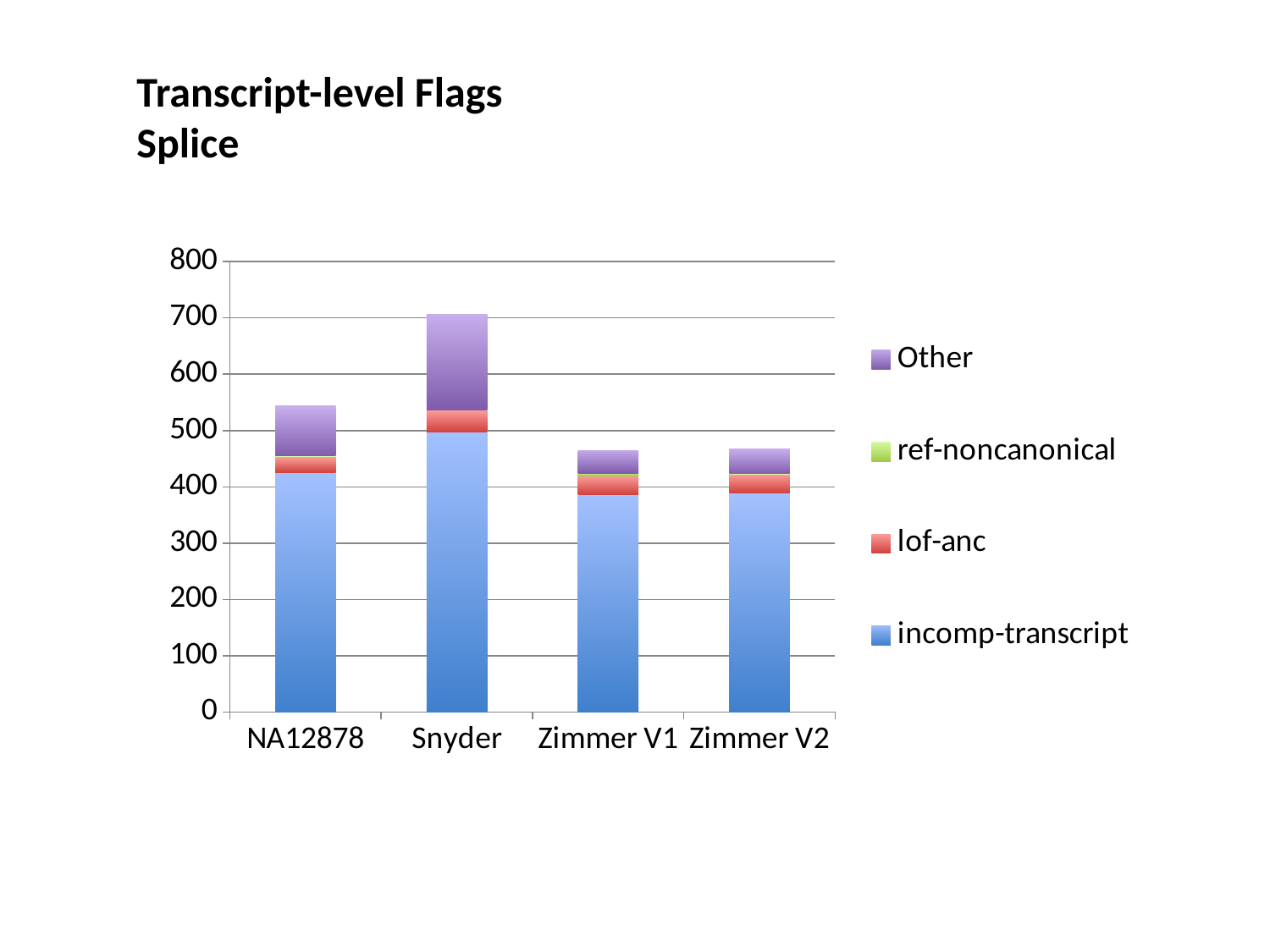
Is the total stacked value for NA12878 greater or less than 500? greater Which category has the larger Other segment, NA12878 or Snyder? Snyder What kind of chart is shown on the slide? stacked bar chart Which category has the tallest stacked bar? Snyder Which stacked bar is taller, NA12878 or Snyder? Snyder Which series forms the bottom segment of each stacked bar? incomp-transcript Is the incomp-transcript value for NA12878 greater or less than 400? greater Is the total stacked value for Snyder greater or less than 600? greater How many series does the legend list? 4 How many categories are shown on the x axis? 4 Which series is shown in green in the legend? ref-noncanonical